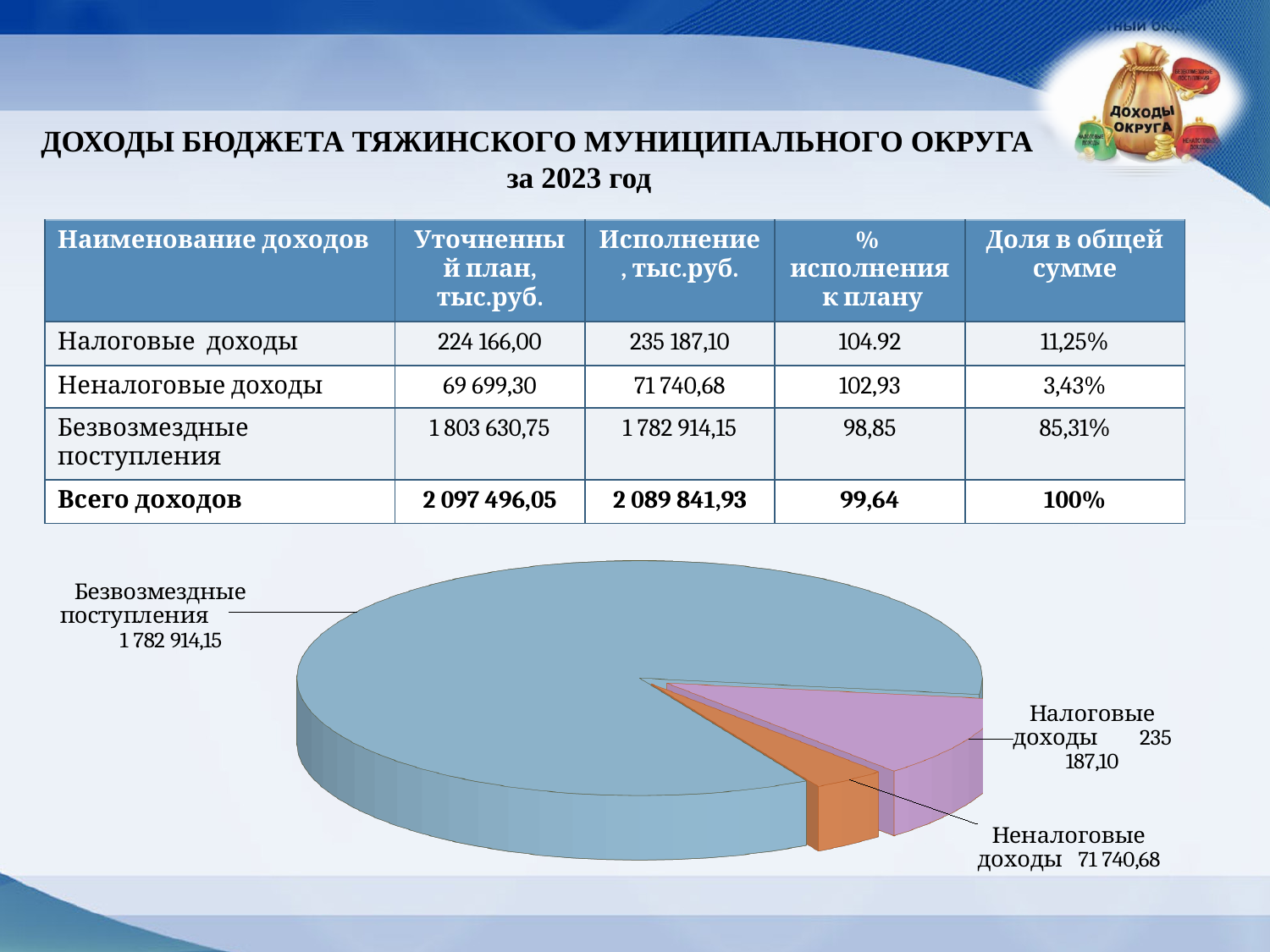
Which is larger in the pie chart: Налоговые доходы or Неналоговые доходы? Налоговые доходы How many slices does the pie chart have? 3 Which slice of the pie chart is the smallest? Неналоговые доходы What is the total of all three slices in the pie chart? 2 089 841,93 Which slice of the pie chart is the largest? Безвозмездные поступления What colour is the Неналоговые доходы slice in the pie chart? orange What share of the pie does Безвозмездные поступления represent? 85,31% What value is shown for Неналоговые доходы in the pie chart? 71 740,68 What kind of chart is shown on the slide? pie chart What value is shown for Налоговые доходы in the pie chart? 235 187,10 What is the difference between the values for Налоговые доходы and Неналоговые доходы in the pie chart? 163 446,42 What value is shown for Безвозмездные поступления in the pie chart? 1 782 914,15